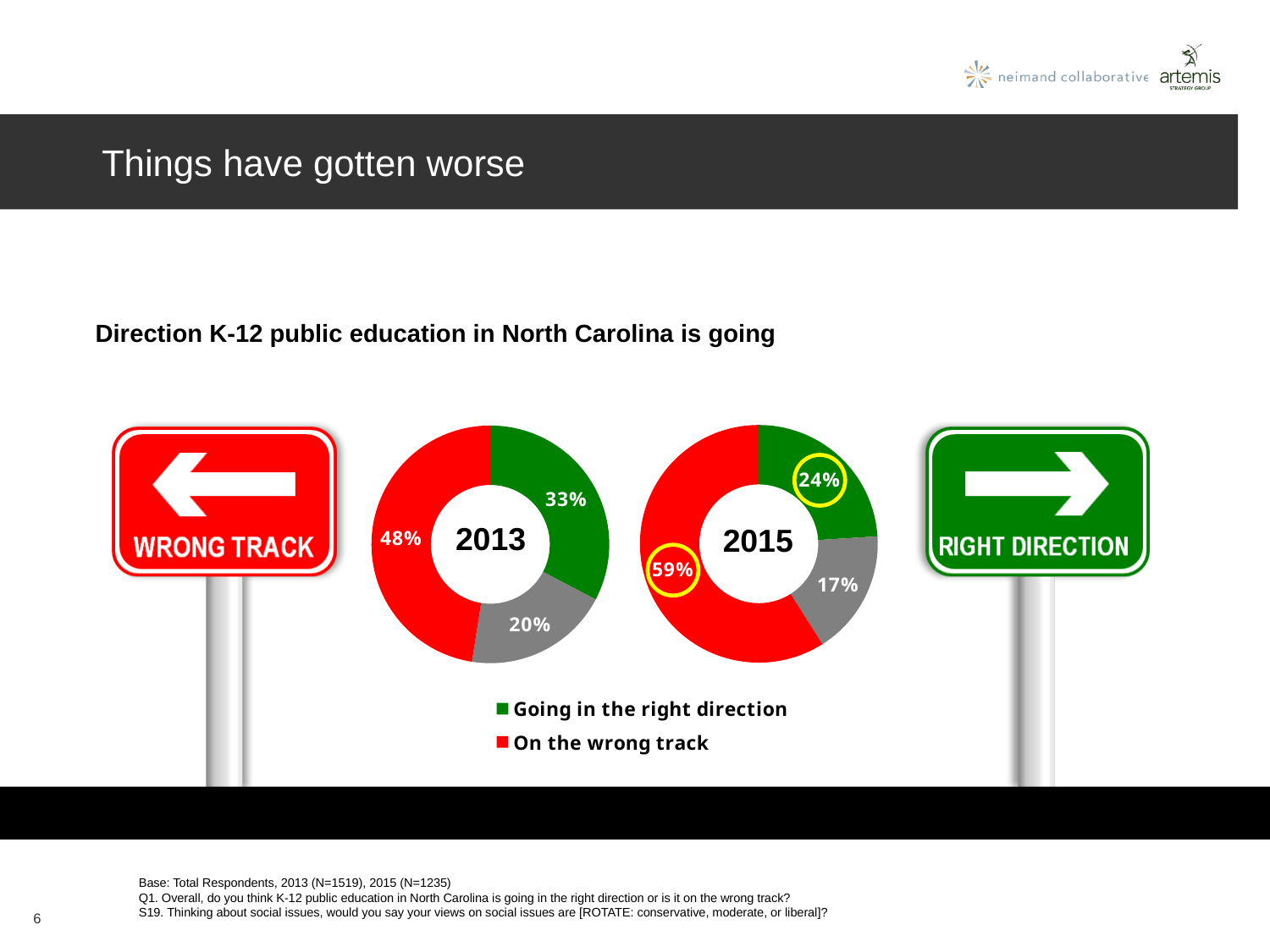
In the 2015 chart, which slice is the largest? On the wrong track Is 'Going in the right direction' larger in the 2013 chart or the 2015 chart? 2013 By how many percentage points did 'On the wrong track' change from the 2013 chart to the 2015 chart? 11 percentage points (48% to 59%) In the 2015 chart, what percentage said K-12 public education is on the wrong track? 59% In the 2015 chart, what percentage said K-12 public education is going in the right direction? 24% How many series does the legend list? 2 In the 2015 chart, what value is shown on the grey slice? 17% In the 2013 chart, which slice is the smallest? The grey slice (20%) What type of chart is used to show the 2013 and 2015 results? Pie (donut) chart In the 2013 chart, what percentage said K-12 public education is going in the right direction? 33% In the 2013 chart, what is the difference between 'On the wrong track' and 'Going in the right direction'? 15 percentage points In the 2013 chart, what percentage said K-12 public education is on the wrong track? 48%